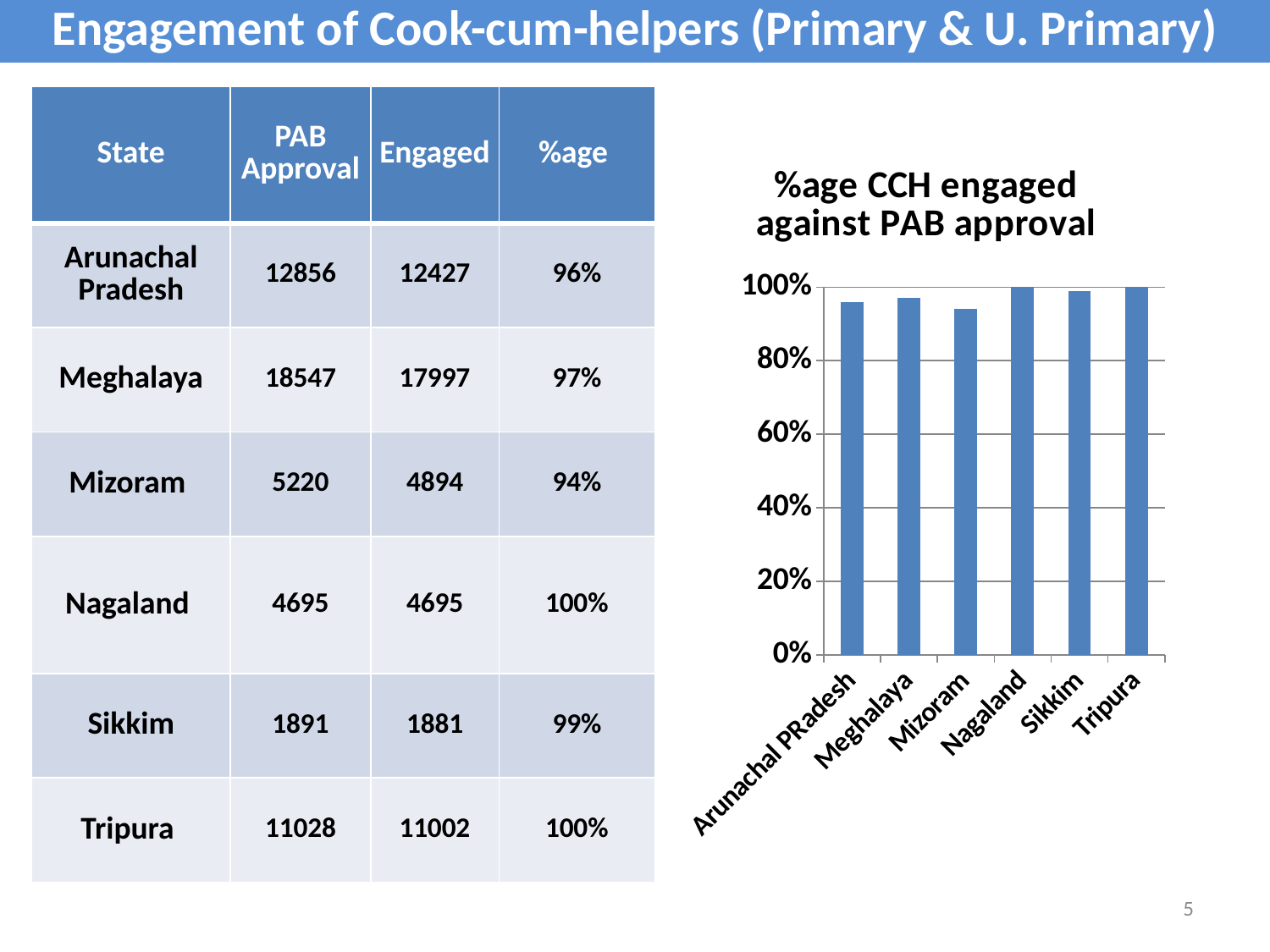
Which state has the lowest bar in the chart? Mizoram What percentage of CCH engaged against PAB approval is shown for Mizoram? 94% Is the value for Mizoram greater or less than 80%? greater How many states are plotted in the chart? 6 What is the difference between the percentage for Nagaland and the percentage for Mizoram? 6% What kind of chart is shown on the slide? bar chart What is the title of the chart? %age CCH engaged against PAB approval Is the value for Arunachal Pradesh greater or less than 60%? greater What percentage of CCH engaged against PAB approval is shown for Meghalaya? 97% What percentage of CCH engaged against PAB approval is shown for Sikkim? 99% What is the highest value shown on the vertical axis of the chart? 100% Which is larger, the value for Mizoram or the value for Nagaland? Nagaland